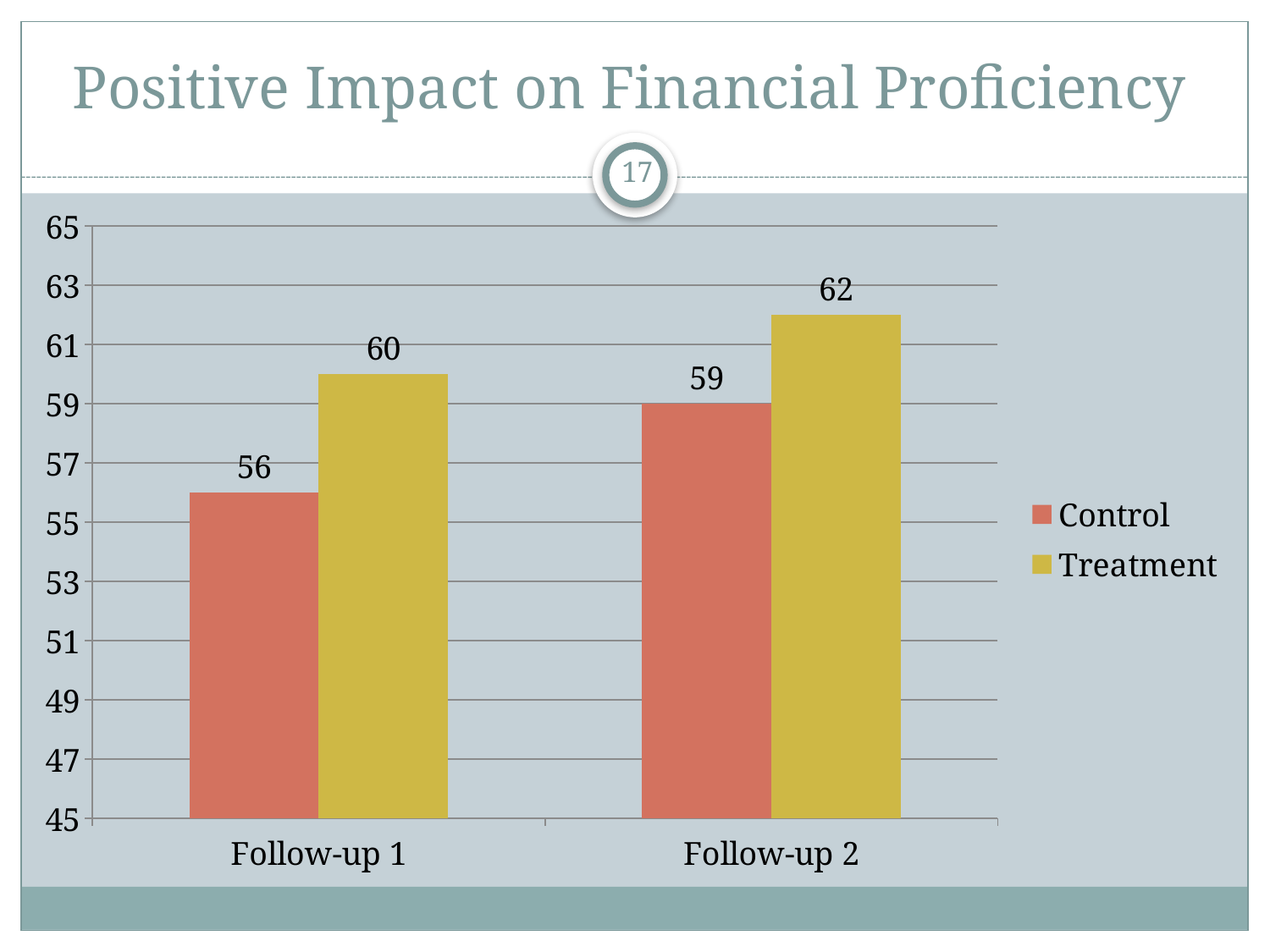
What is the Control value at Follow-up 1? 56 Which bar has the lowest value on the chart? Control at Follow-up 1 Which is larger at Follow-up 2, Control or Treatment? Treatment Does the Control value rise or fall from Follow-up 1 to Follow-up 2? Rise How many series does the legend list? 2 What is the Treatment value at Follow-up 2? 62 What is the Control value at Follow-up 2? 59 What is the difference between the Treatment and Control values at Follow-up 1? 4 What kind of chart is shown on the slide? Bar chart What is the Treatment value at Follow-up 1? 60 Which bar has the highest value on the chart? Treatment at Follow-up 2 What is the difference between the Treatment and Control values at Follow-up 2? 3